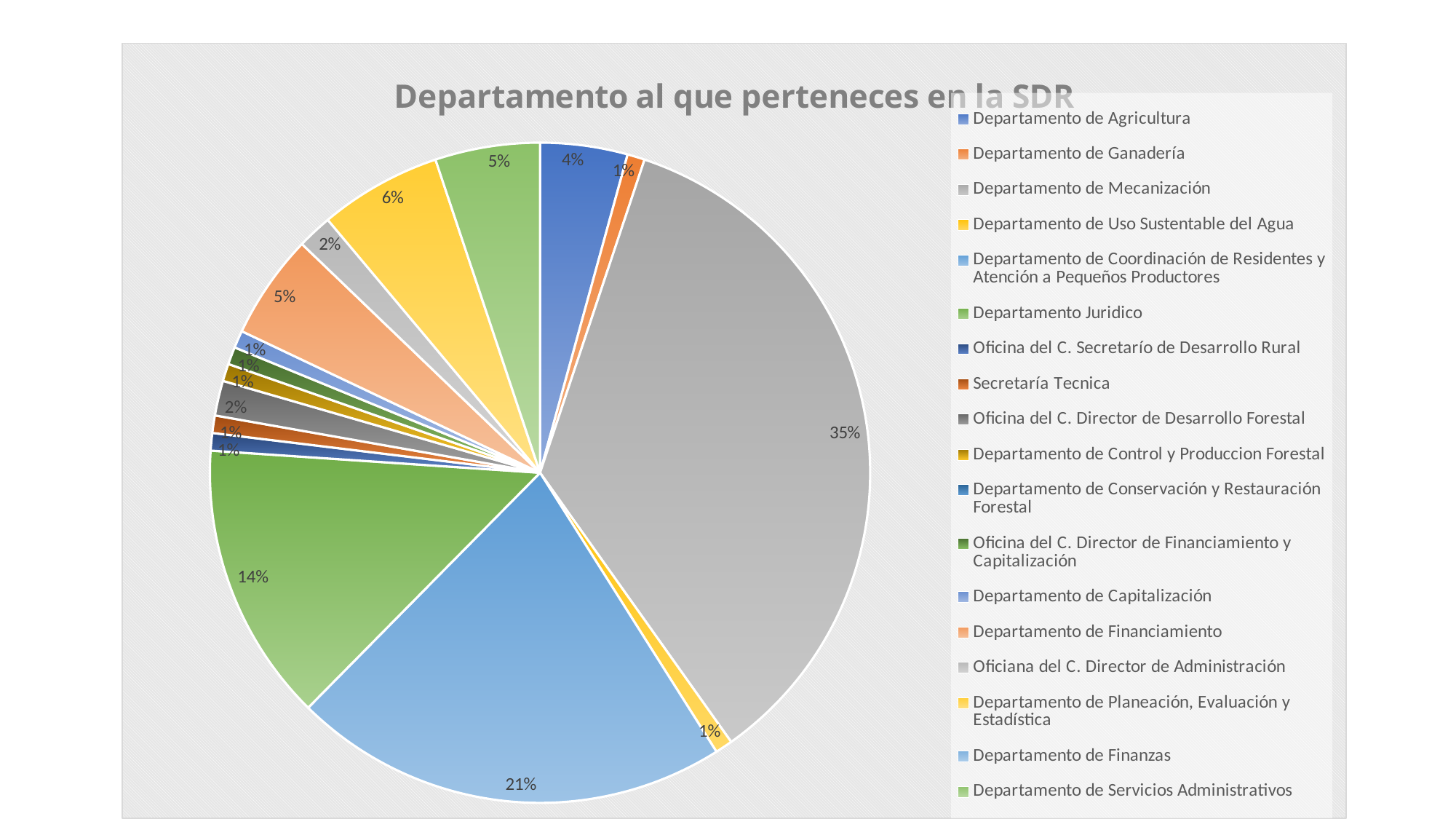
What share of the pie does Departamento Juridico have? 14% Which has a larger share, Departamento Juridico or Departamento de Agricultura? Departamento Juridico What is the difference in percentage points between Departamento de Planeación, Evaluación y Estadística and Departamento de Agricultura? 2 What is the difference in percentage points between Departamento de Mecanización and Departamento de Coordinación de Residentes y Atención a Pequeños Productores? 14 What share of the pie does Departamento de Agricultura have? 4% Which department has the largest slice of the pie? Departamento de Mecanización What share of the pie does Departamento de Mecanización have? 35% What share of the pie does Departamento de Coordinación de Residentes y Atención a Pequeños Productores have? 21% What type of chart is shown on the slide? pie chart What is the title of the chart? Departamento al que perteneces en la SDR What share of the pie does Departamento de Planeación, Evaluación y Estadística have? 6% How many entries does the legend list? 18